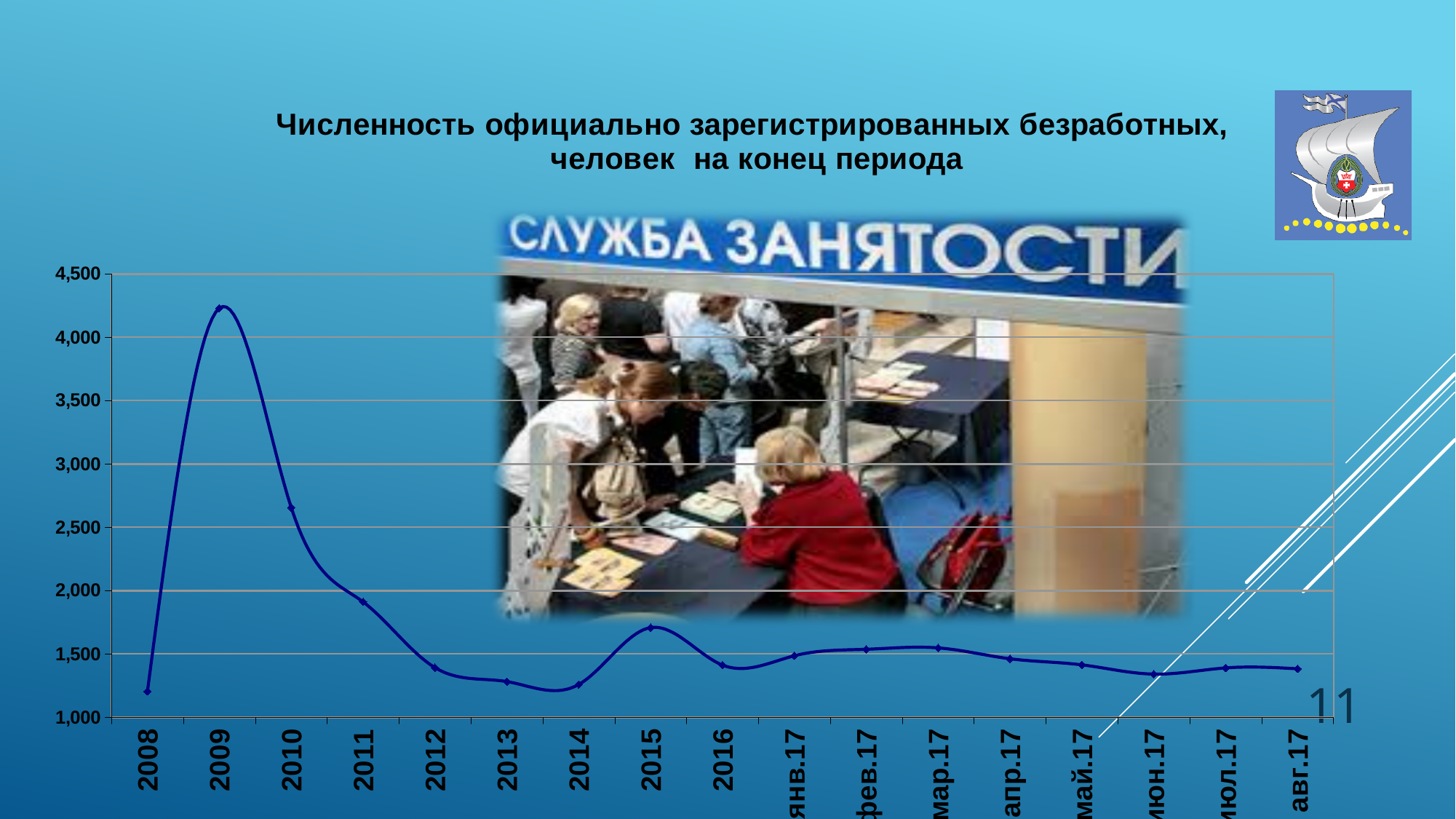
Is the value for 2009 greater or less than 4,000? greater Which period has the highest number of registered unemployed? 2009 What is the highest tick value shown on the vertical axis? 4,500 Which is larger, the value for 2015 or the value for 2016? 2015 Is the value for 2011 greater or less than 2,000? less How many data points are plotted along the x axis? 17 What kind of chart is shown on the slide? line chart Which is larger, the value for 2009 or the value for 2010? 2009 Do the values rise or fall from 2009 to 2012? fall Is the value for 2008 greater or less than 1,500? less